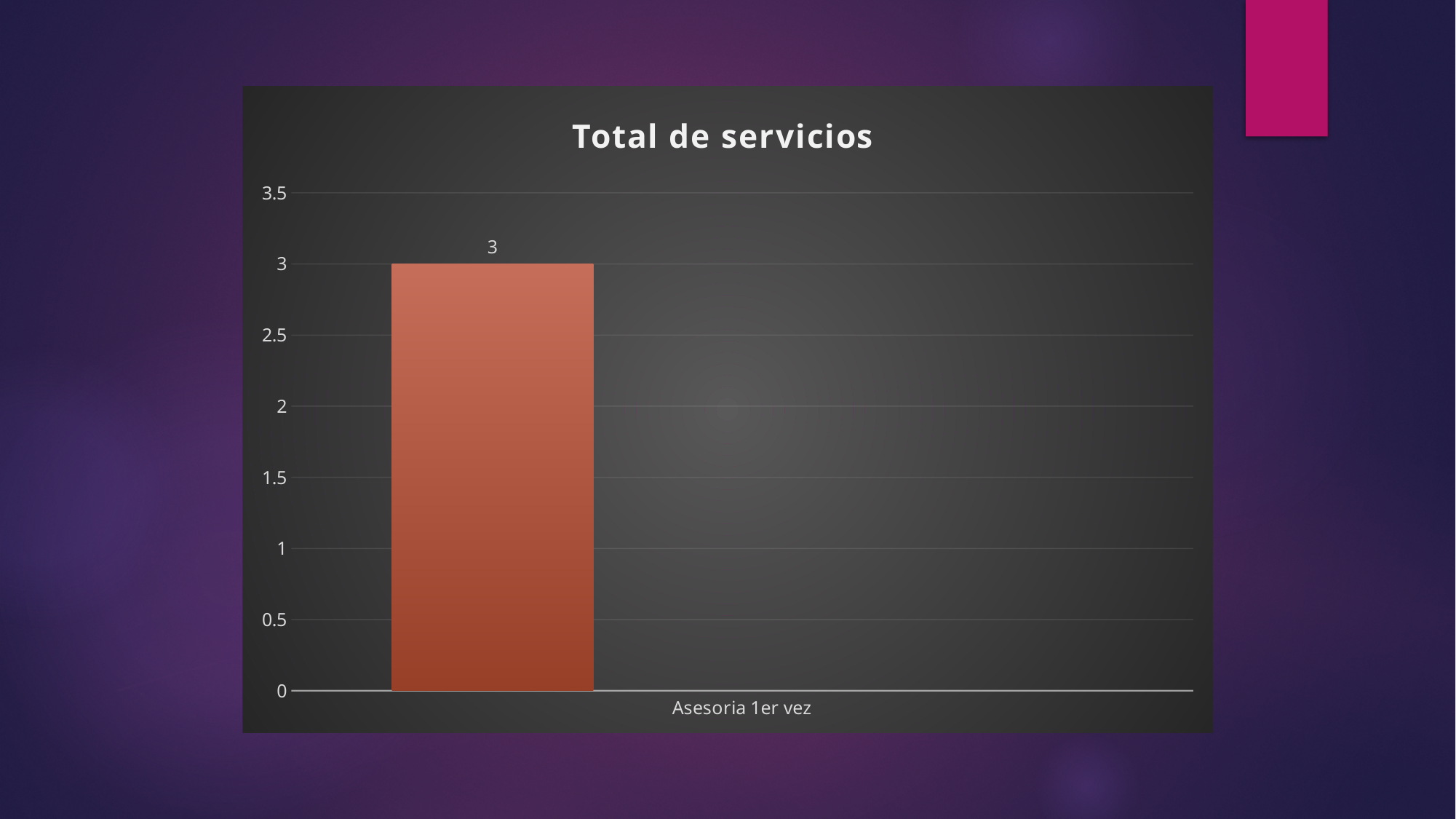
What is the title of the chart? Total de servicios What type of chart is shown on the slide? bar chart Is the value for Asesoria 1er vez greater or less than 3.5? less How many bars are plotted in the chart? 1 Is the value for Asesoria 1er vez greater or less than 2? greater What is the label of the category on the x axis? Asesoria 1er vez What is the value for Asesoria 1er vez? 3 What is the highest value shown on the vertical axis? 3.5